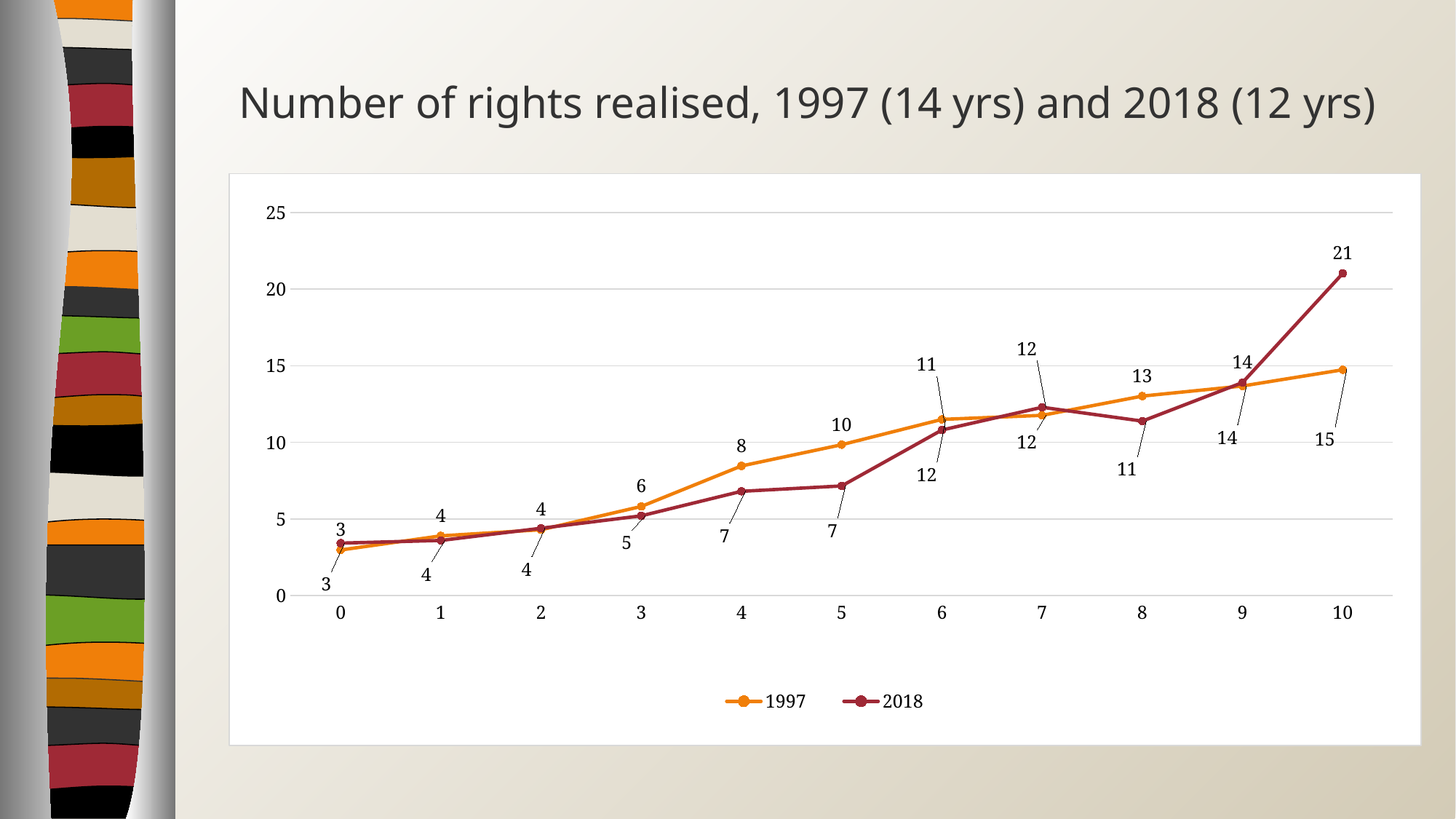
How many series does the legend list? 2 What are the two series named in the legend? 1997 and 2018 What is the value of the 2018 series at x = 10? 21 At which x value does the 2018 series reach its highest value? 10 What is the value of the 1997 series at x = 5? 10 What is the value of the 1997 series at x = 10? 15 At x = 5, which series has the larger value, 1997 or 2018? 1997 What is the value of the 2018 series at x = 8? 11 How many points are plotted along the x axis for each series? 11 Is the value of the 2018 series at x = 10 greater or less than 20? greater What kind of chart is shown on the slide? line chart What is the difference between the 2018 and 1997 values at x = 10? 6